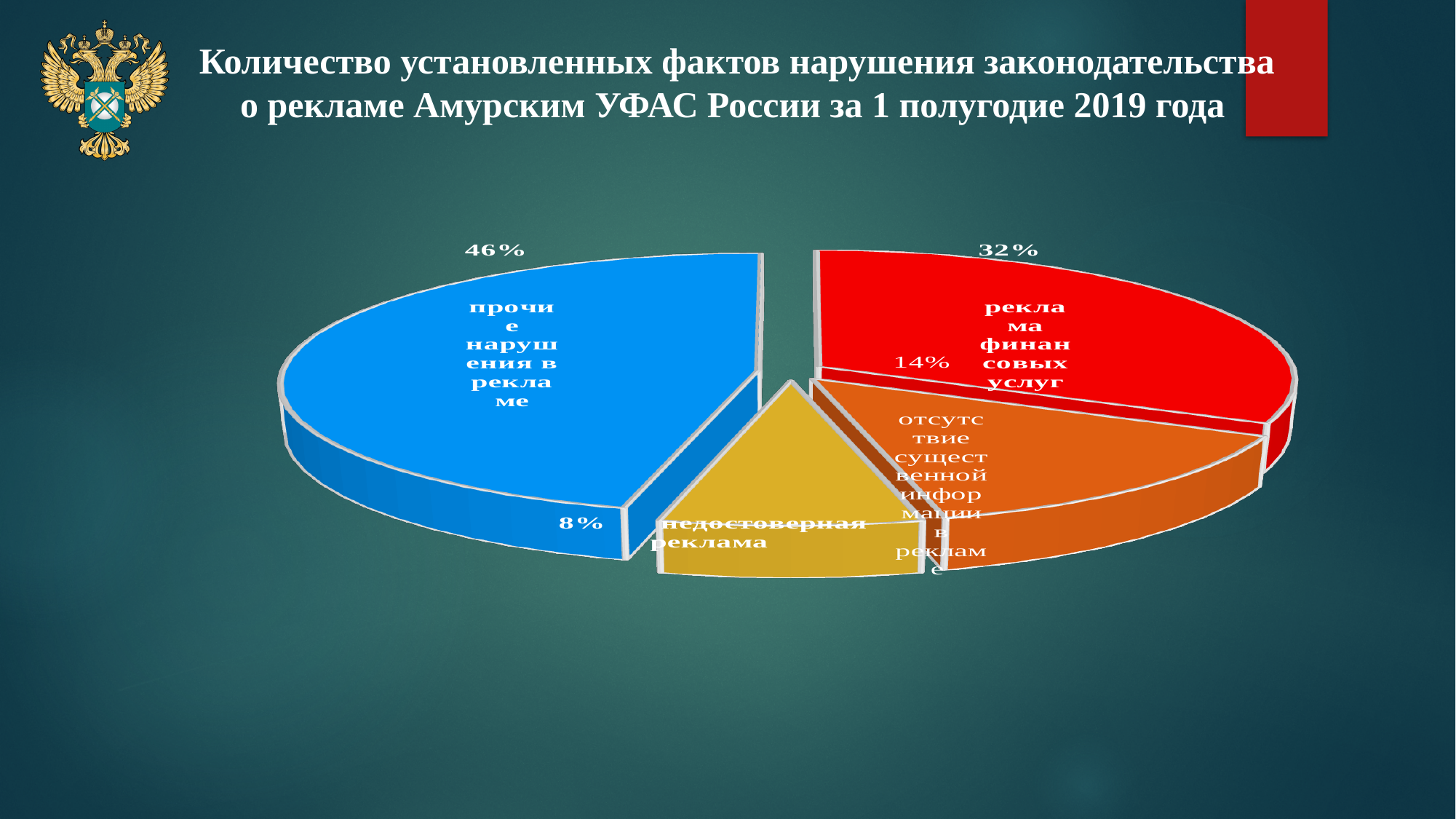
What kind of chart is shown on the slide? pie chart Which category has the smallest slice of the pie? недостоверная реклама What is the difference in percentage points between "прочие нарушения в рекламе" and "реклама финансовых услуг"? 14 What share of the pie does "прочие нарушения в рекламе" have? 46% What is the difference in percentage points between "реклама финансовых услуг" and "недостоверная реклама"? 24 What share of the pie does "недостоверная реклама" have? 8% What share of the pie does "отсутствие существенной информации в рекламе" have? 14% How many slices does the pie chart have? 4 Which is larger: the share for "отсутствие существенной информации в рекламе" or the share for "недостоверная реклама"? отсутствие существенной информации в рекламе What colour is the slice for "реклама финансовых услуг"? red What share of the pie does "реклама финансовых услуг" have? 32% Which category has the largest slice of the pie? прочие нарушения в рекламе